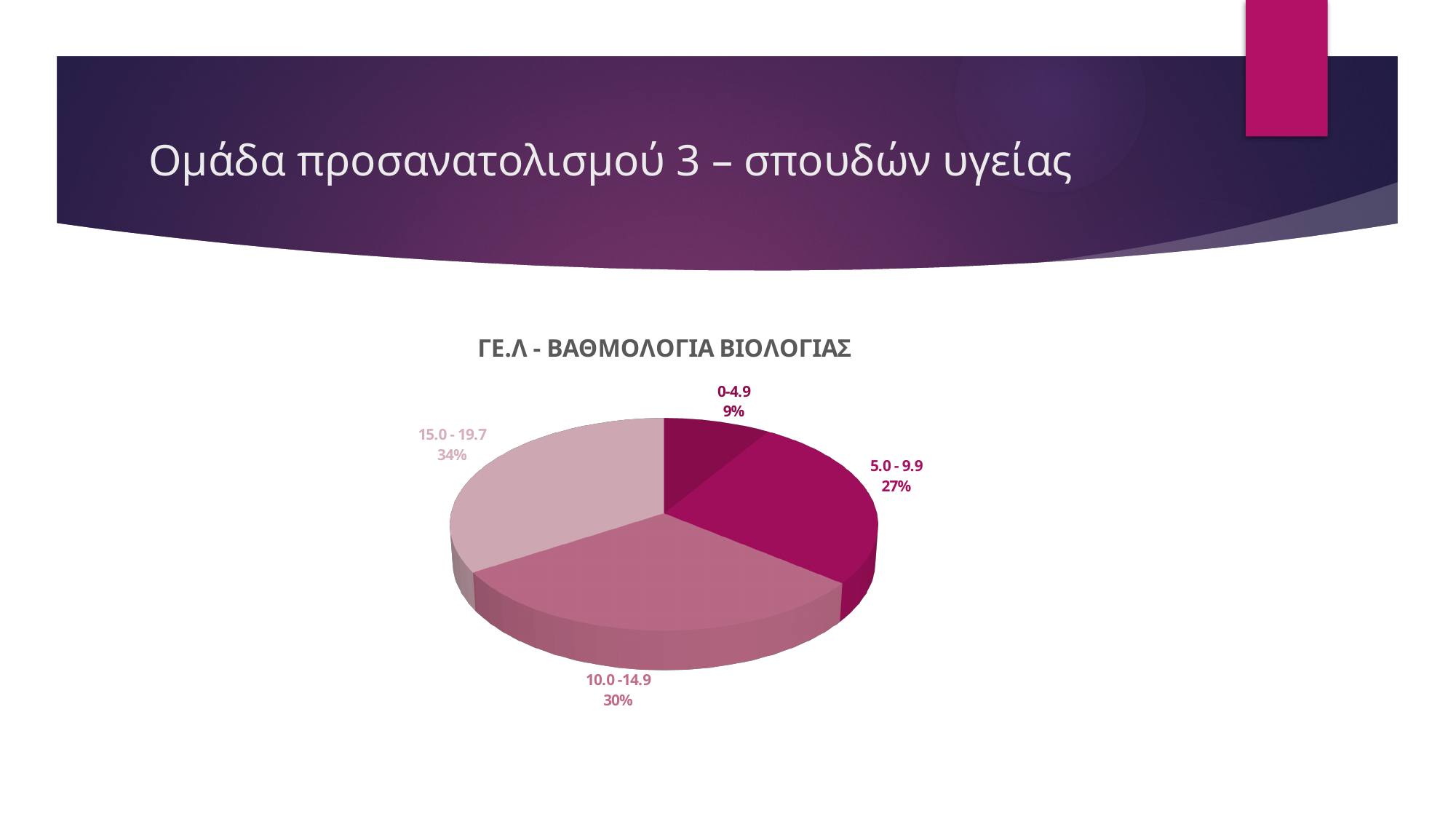
What share of the pie does the 10.0 -14.9 slice represent? 30% How many slices does the pie chart have? 4 What share of the pie does the 0-4.9 slice represent? 9% Which is larger, the 5.0 - 9.9 slice or the 0-4.9 slice? 5.0 - 9.9 What is the title of the chart? ΓΕ.Λ - ΒΑΘΜΟΛΟΓΙΑ ΒΙΟΛΟΓΙΑΣ What is the difference in percentage points between the 10.0 -14.9 slice and the 5.0 - 9.9 slice? 3 What kind of chart is shown on the slide? Pie chart What share of the pie does the 15.0 - 19.7 slice represent? 34% What is the difference in percentage points between the 15.0 - 19.7 slice and the 0-4.9 slice? 25 Which grade range has the smallest share of the pie? 0-4.9 Which grade range has the largest share of the pie? 15.0 - 19.7